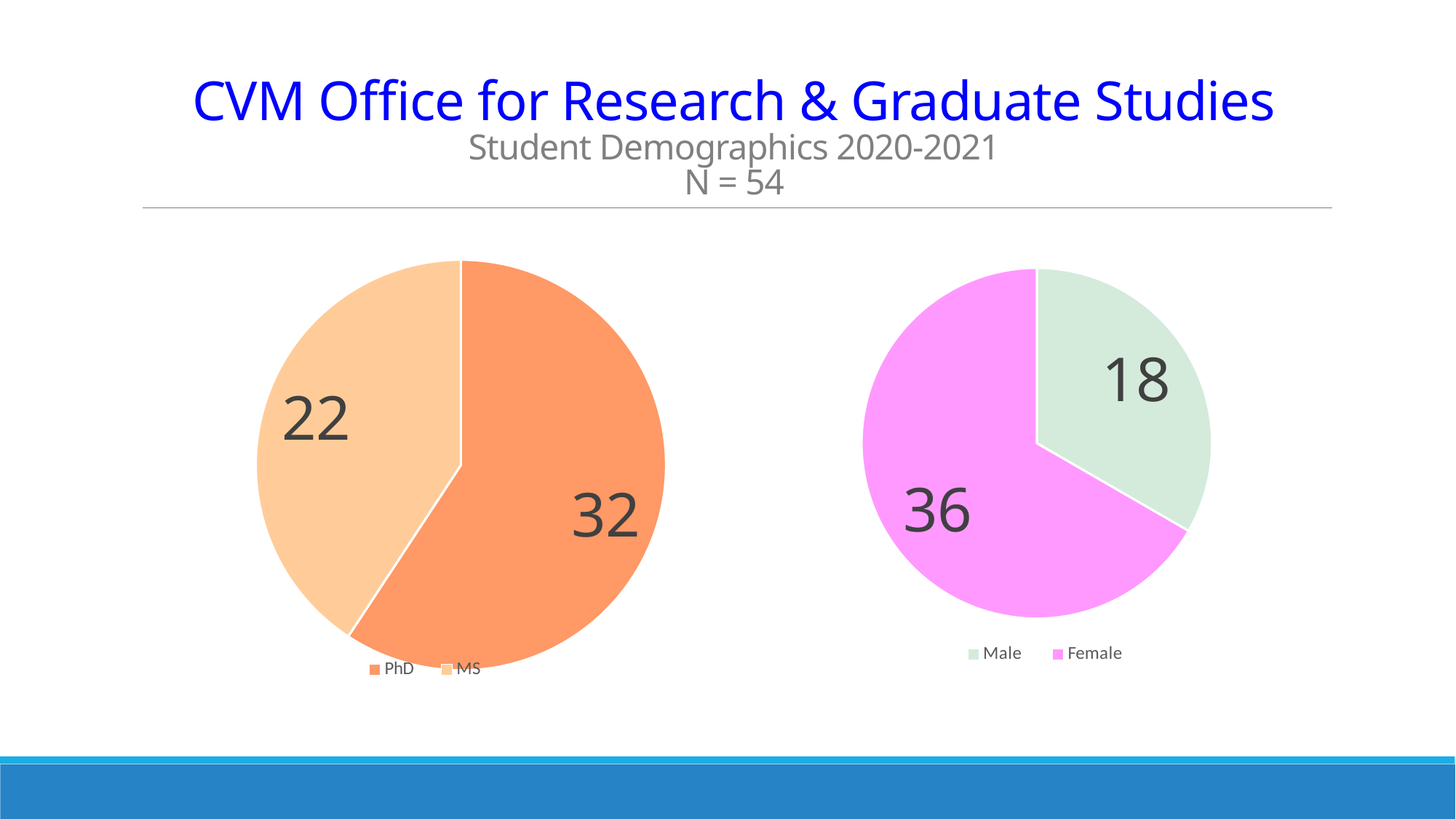
In the right pie chart, which is larger, Male or Female? Female In the left pie chart, which category has the largest slice? PhD What type of chart is shown on the right side of the slide? Pie chart In the right pie chart, what colour is the Female slice? Pink In the right pie chart, which category has the smallest slice? Male In the right pie chart, what is the value for Male? 18 How many slices does the left pie chart have? 2 In the right pie chart, what is the value for Female? 36 In the left pie chart, what is the value for MS? 22 In the right pie chart, what is the difference between the Female and Male values? 18 In the left pie chart, what is the difference between the PhD and MS values? 10 In the left pie chart, what is the value for PhD? 32